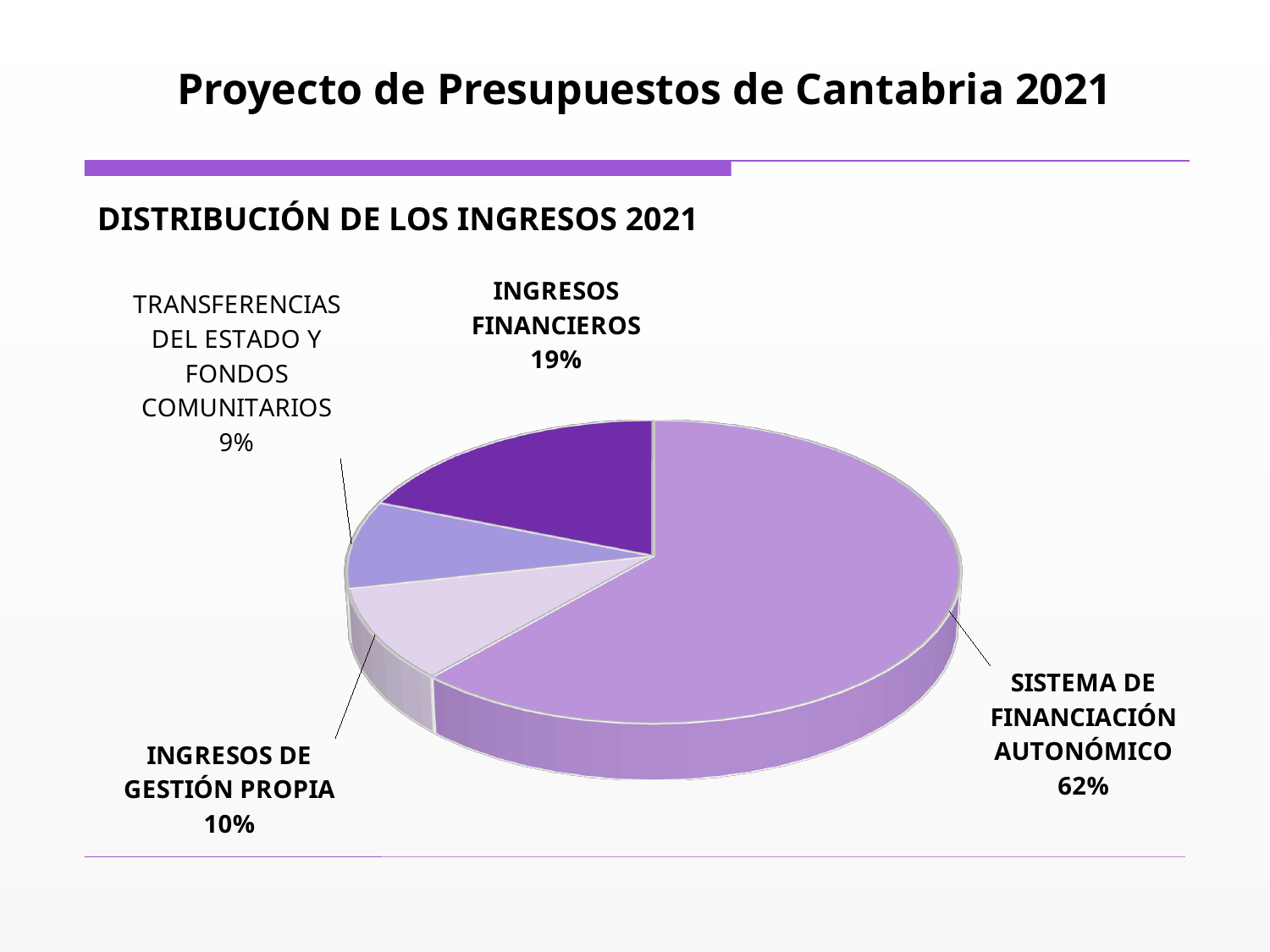
What is the value shown for INGRESOS FINANCIEROS? 19% What share of the pie does SISTEMA DE FINANCIACIÓN AUTONÓMICO represent? 62% What is the value shown for TRANSFERENCIAS DEL ESTADO Y FONDOS COMUNITARIOS? 9% What is the title of the chart? DISTRIBUCIÓN DE LOS INGRESOS 2021 Which category has the smallest slice of the pie? TRANSFERENCIAS DEL ESTADO Y FONDOS COMUNITARIOS What kind of chart is shown on the slide? Pie chart Which is larger, INGRESOS FINANCIEROS or INGRESOS DE GESTIÓN PROPIA? INGRESOS FINANCIEROS What is the combined share of INGRESOS DE GESTIÓN PROPIA and TRANSFERENCIAS DEL ESTADO Y FONDOS COMUNITARIOS? 19% What is the value shown for INGRESOS DE GESTIÓN PROPIA? 10% Which category has the largest slice of the pie? SISTEMA DE FINANCIACIÓN AUTONÓMICO What is the difference in percentage points between SISTEMA DE FINANCIACIÓN AUTONÓMICO and INGRESOS FINANCIEROS? 43 How many categories are shown in the pie chart? 4